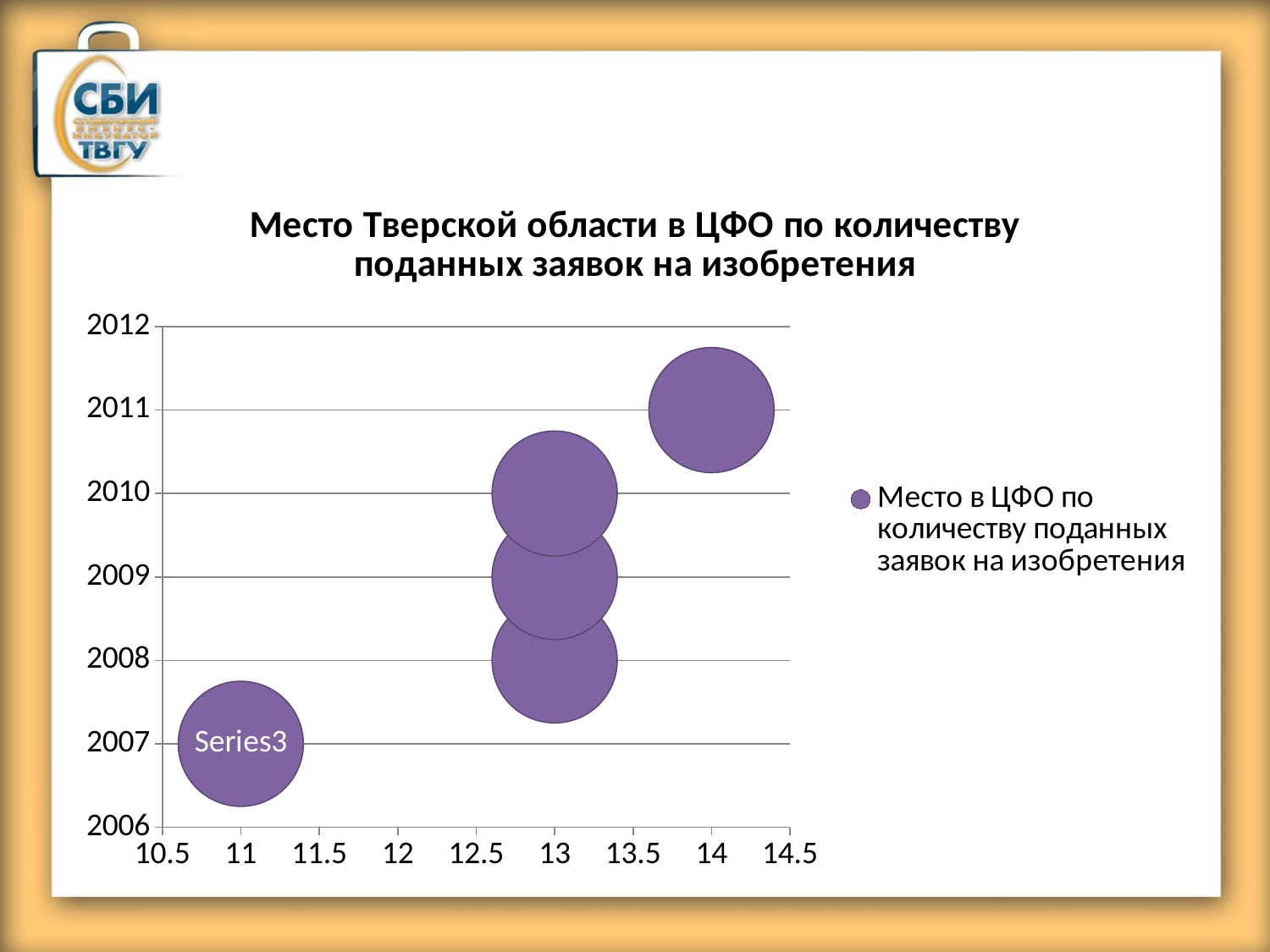
How many bubbles are plotted on the chart? 5 What is the title of the chart? Место Тверской области в ЦФО по количеству поданных заявок на изобретения How many series does the legend list? 1 What x-axis value does the bubble for 2009 land on? 13 Is the x-axis value for 2011 greater or less than 13.5? greater Which year has the bubble with the highest x-axis value? 2011 What is the difference between the x-axis values for 2011 and 2007? 3 Which year has the bubble with the lowest x-axis value? 2007 What x-axis value does the bubble for 2007 land on? 11 Which year has a larger x-axis value, 2008 or 2011? 2011 What x-axis value does the bubble for 2011 land on? 14 What kind of chart is shown on the slide? bubble chart